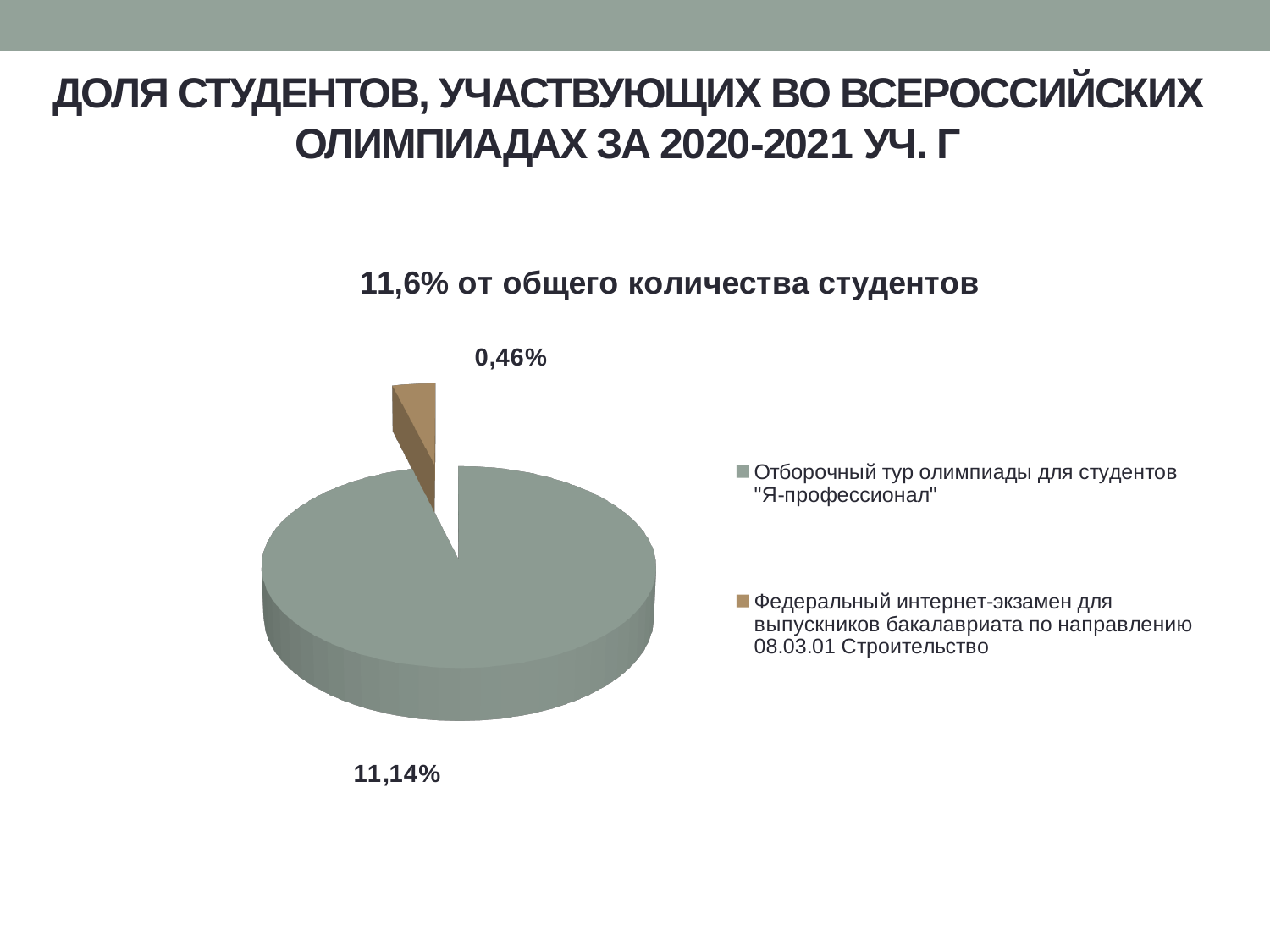
How many slices does the pie chart have? 2 What kind of chart is shown on the slide? pie chart What is the title of the chart? 11,6% от общего количества студентов How many entries does the legend list? 2 What is the difference between the values of the two slices (11,14% and 0,46%)? 10,68% Which slice of the pie is the largest? Отборочный тур олимпиады для студентов "Я-профессионал" Which is larger: the value for "Отборочный тур олимпиады" or the value for "Федеральный интернет-экзамен"? Отборочный тур олимпиады для студентов "Я-профессионал" What is the value for the slice "Федеральный интернет-экзамен для выпускников бакалавриата по направлению 08.03.01 Строительство"? 0,46% Which slice of the pie is the smallest? Федеральный интернет-экзамен для выпускников бакалавриата по направлению 08.03.01 Строительство What is the value for the slice "Отборочный тур олимпиады для студентов "Я-профессионал""? 11,14% What colour is the slice for "Федеральный интернет-экзамен для выпускников бакалавриата по направлению 08.03.01 Строительство"? brown What is the sum of the two slice values shown on the chart? 11,6%